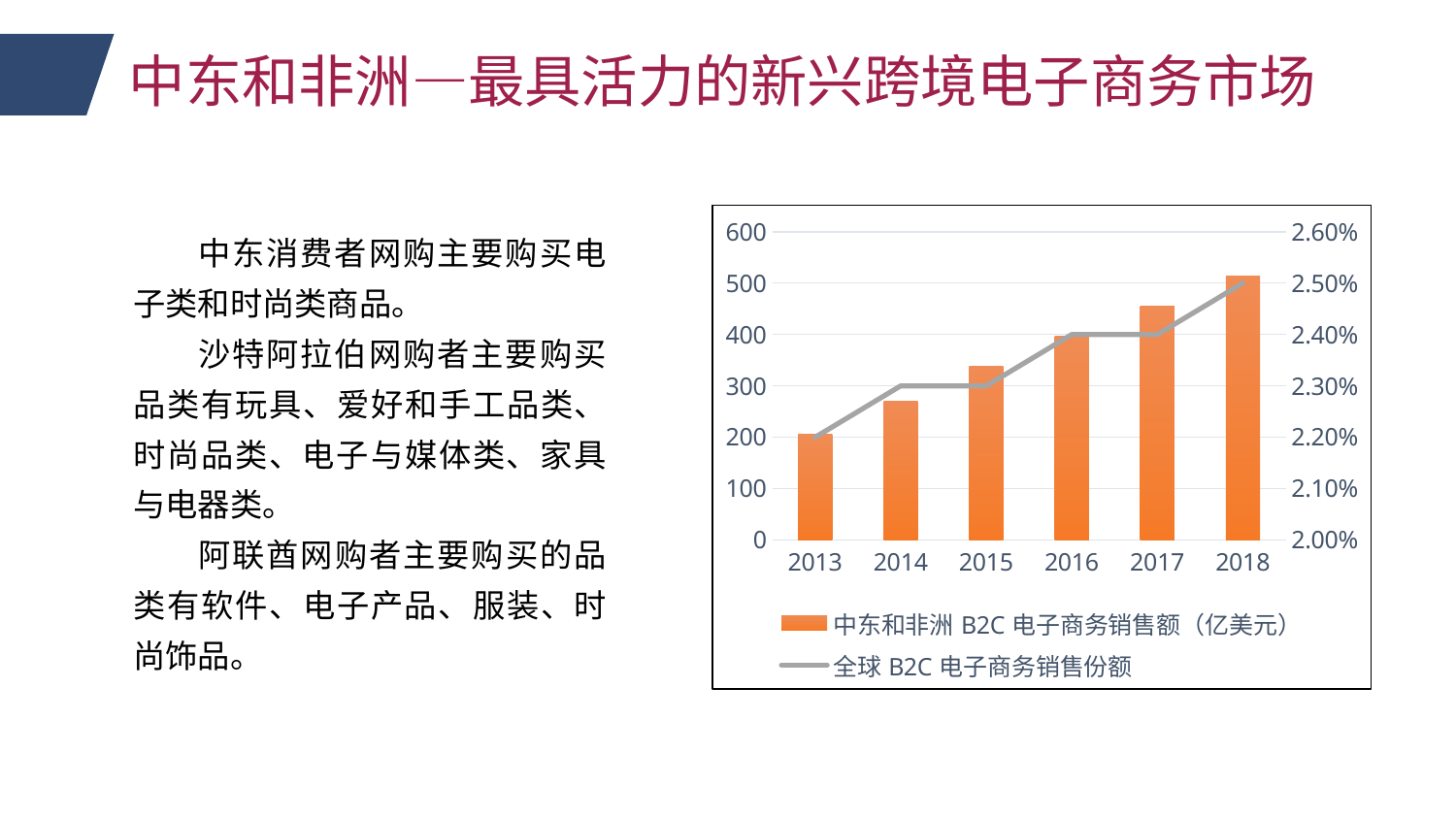
Is the 中东和非洲 B2C 电子商务销售额 value for 2014 greater or less than 300? less Which is larger, the 中东和非洲 B2C 电子商务销售额 bar for 2017 or for 2016? 2017 Is the 中东和非洲 B2C 电子商务销售额 value for 2018 greater or less than 500? greater How many years are shown on the x axis of the chart? 6 Is the 中东和非洲 B2C 电子商务销售额 value for 2015 greater or less than 300? greater Which year has the highest 中东和非洲 B2C 电子商务销售额 bar? 2018 How many series does the chart legend list? 2 Which year has the lowest 中东和非洲 B2C 电子商务销售额 bar? 2013 Do the 中东和非洲 B2C 电子商务销售额 bars rise or fall from 2013 to 2018? Rise What is the first series listed in the chart legend? 中东和非洲 B2C 电子商务销售额（亿美元） What kind of chart is shown on the slide? A combined bar and line chart